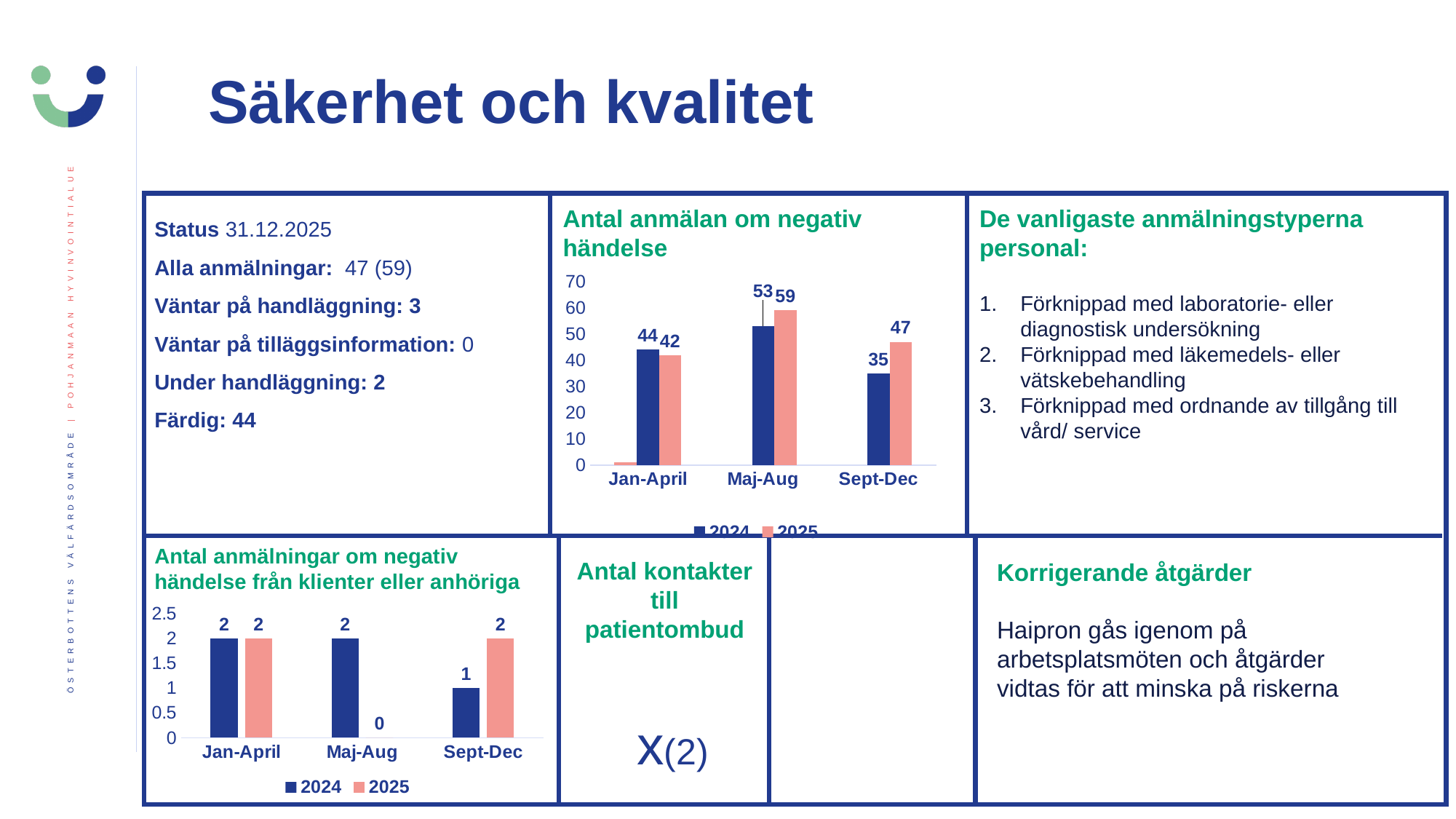
What kind of chart is 'Antal anmälningar om negativ händelse från klienter eller anhöriga'? Bar chart In the chart 'Antal anmälningar om negativ händelse från klienter eller anhöriga', what is the 2025 value for Maj-Aug? 0 In the chart 'Antal anmälan om negativ händelse', what is the difference between the 2025 and 2024 values for Sept-Dec? 12 In the chart 'Antal anmälningar om negativ händelse från klienter eller anhöriga', what is the 2024 value for Sept-Dec? 1 In the chart 'Antal anmälan om negativ händelse', which period has the lowest 2025 value? Jan-April How many periods are shown on the x axis of the chart 'Antal anmälningar om negativ händelse från klienter eller anhöriga'? 3 In the chart 'Antal anmälan om negativ händelse', what is the 2024 value for Sept-Dec? 35 In the chart 'Antal anmälan om negativ händelse', what is the 2025 value for Maj-Aug? 59 In the chart 'Antal anmälan om negativ händelse', which is larger for Jan-April, the 2024 value or the 2025 value? 2024 In the chart 'Antal anmälan om negativ händelse', what colour are the 2025 bars? Pink In the chart 'Antal anmälan om negativ händelse', which period has the highest 2024 value? Maj-Aug In the chart 'Antal anmälan om negativ händelse', how many series does the legend list? 2